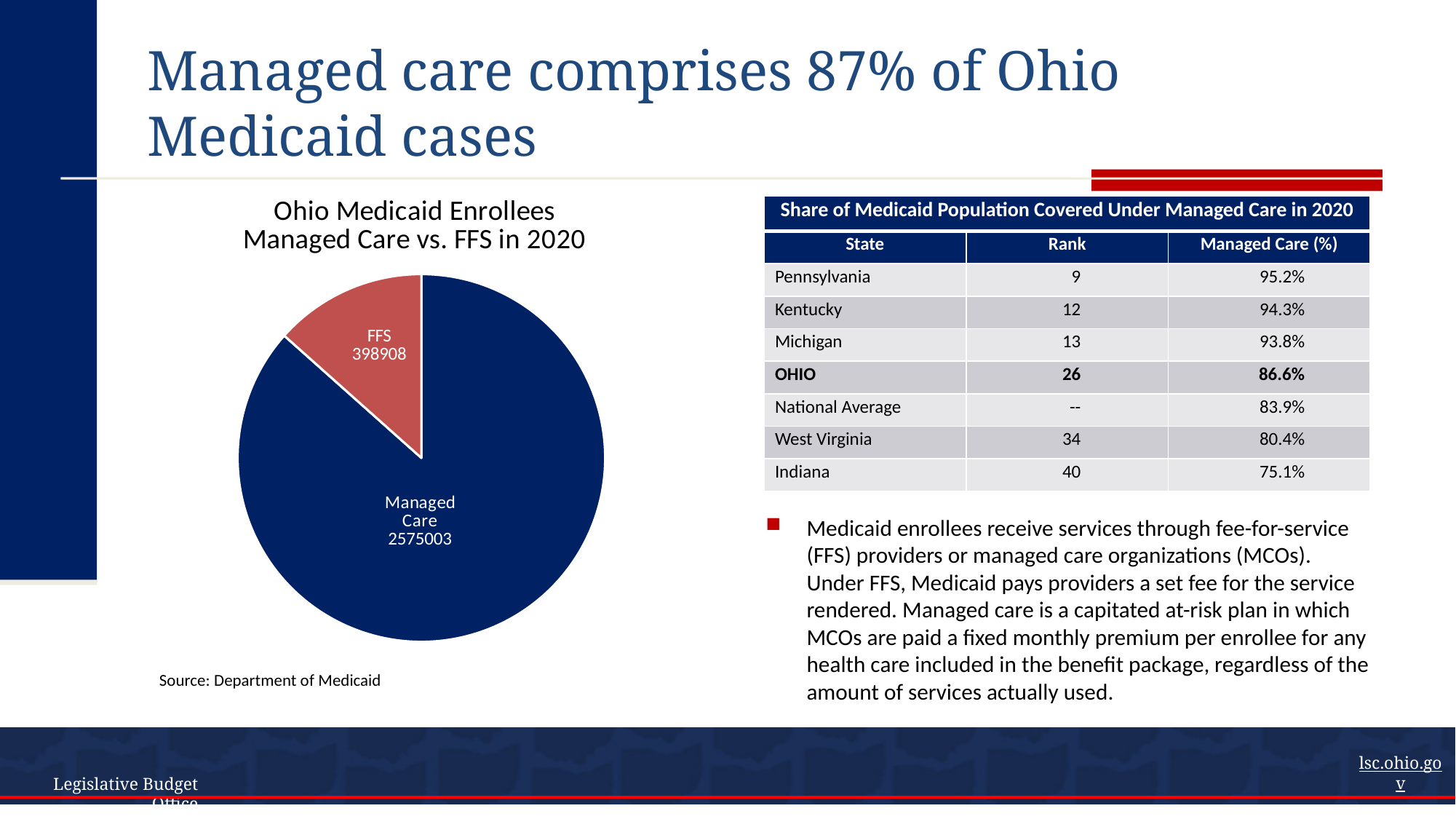
To one decimal place, what percentage of the pie chart does the Managed Care slice represent? 86.6% In the pie chart, which has more enrollees, Managed Care or FFS? Managed Care Which slice of the pie chart is the largest? Managed Care What colour is the FFS slice in the pie chart? red In the pie chart, how many enrollees are in FFS? 398908 Which slice of the pie chart is the smallest? FFS In the pie chart, how many enrollees are in Managed Care? 2575003 What is the total number of enrollees shown in the pie chart? 2973911 What is the title of the pie chart? Ohio Medicaid Enrollees Managed Care vs. FFS in 2020 What kind of chart is shown on the slide? pie chart In the pie chart, how many more enrollees are in Managed Care than in FFS? 2176095 How many slices does the pie chart have? 2